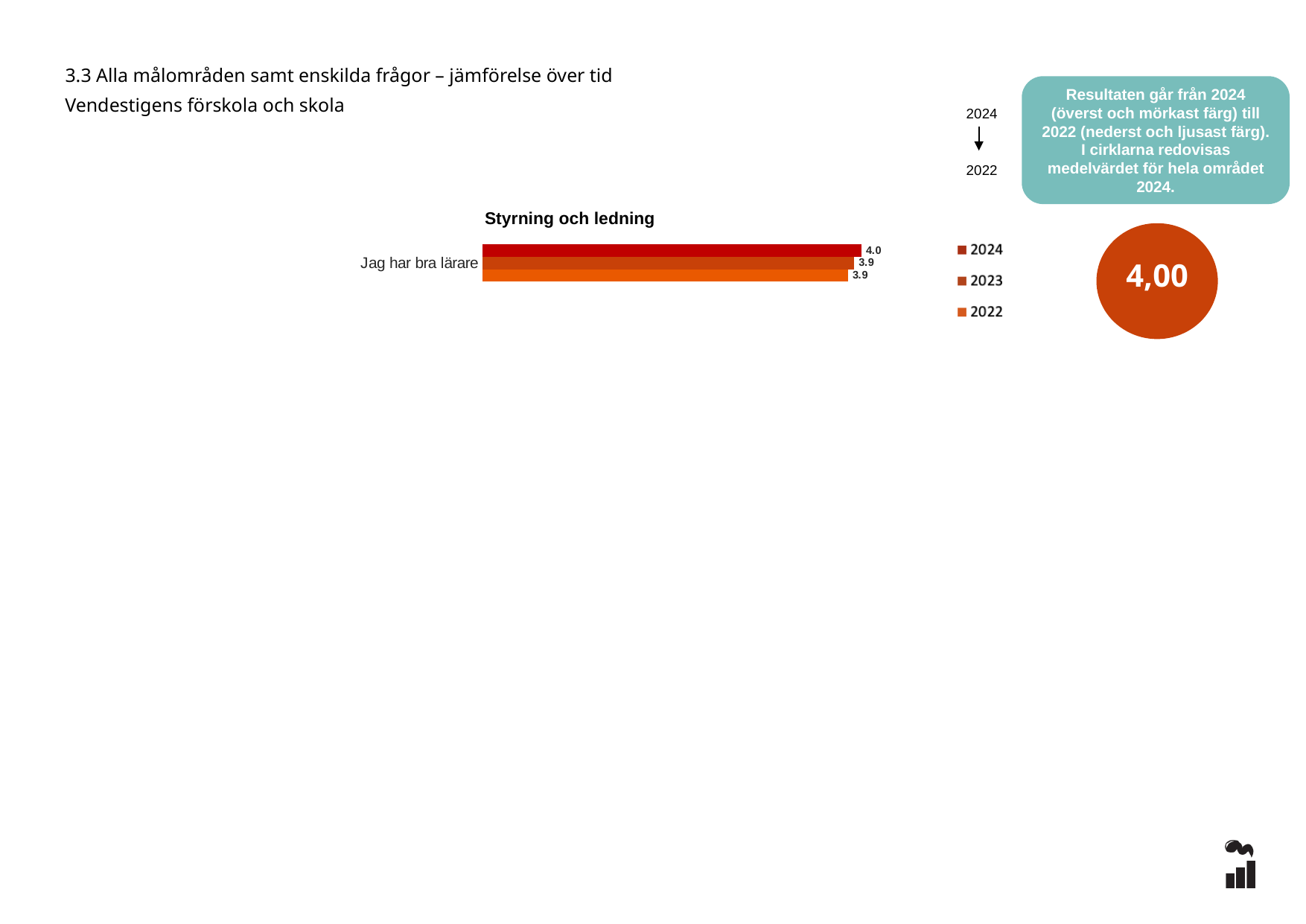
What is the value for 'Jag har bra lärare' in 2023 in the 'Styrning och ledning' chart? 3.9 Is the 2024 value for 'Jag har bra lärare' larger than the 2023 value? Yes What is the title of the chart on the slide? Styrning och ledning What is the value for 'Jag har bra lärare' in 2022 in the 'Styrning och ledning' chart? 3.9 What kind of chart is 'Styrning och ledning'? Bar chart What is the value for 'Jag har bra lärare' in 2024 in the 'Styrning och ledning' chart? 4.0 How many categories are shown in the 'Styrning och ledning' chart? 1 How many series does the legend of the 'Styrning och ledning' chart list? 3 What mean value for the whole area in 2024 is shown in the circle next to the chart? 4,00 What is the difference between the 2024 and 2022 values for 'Jag har bra lärare'? 0.1 Which year has the highest value for 'Jag har bra lärare' in the 'Styrning och ledning' chart? 2024